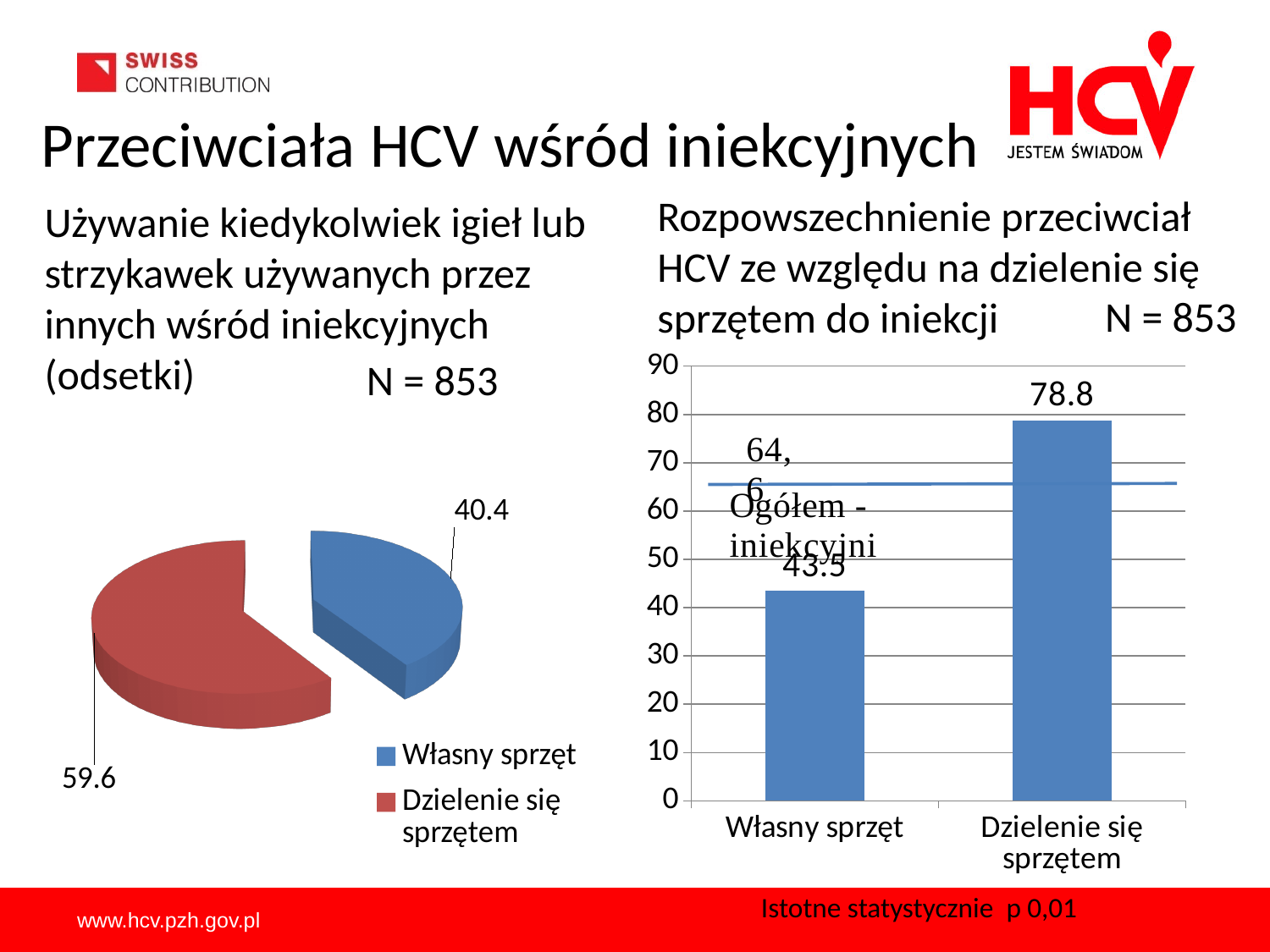
On the pie chart on the left, what is the difference between the two slices? 19.2 On the bar chart on the right, what is the value for "Własny sprzęt"? 43.5 On the bar chart on the right, which category has the highest value? Dzielenie się sprzętem What kind of chart is on the right side of the slide? Bar chart On the pie chart on the left, what is the value for "Własny sprzęt"? 40.4 On the pie chart on the left, how many slices are there? 2 On the bar chart on the right, what is the value for "Dzielenie się sprzętem"? 78.8 On the bar chart on the right, what is the difference between "Dzielenie się sprzętem" and "Własny sprzęt"? 35.3 On the bar chart on the right, is the value for "Własny sprzęt" greater or less than 50? less On the pie chart on the left, which category has the larger slice? Dzielenie się sprzętem What kind of chart is on the left side of the slide? Pie chart On the pie chart on the left, what is the value for "Dzielenie się sprzętem"? 59.6